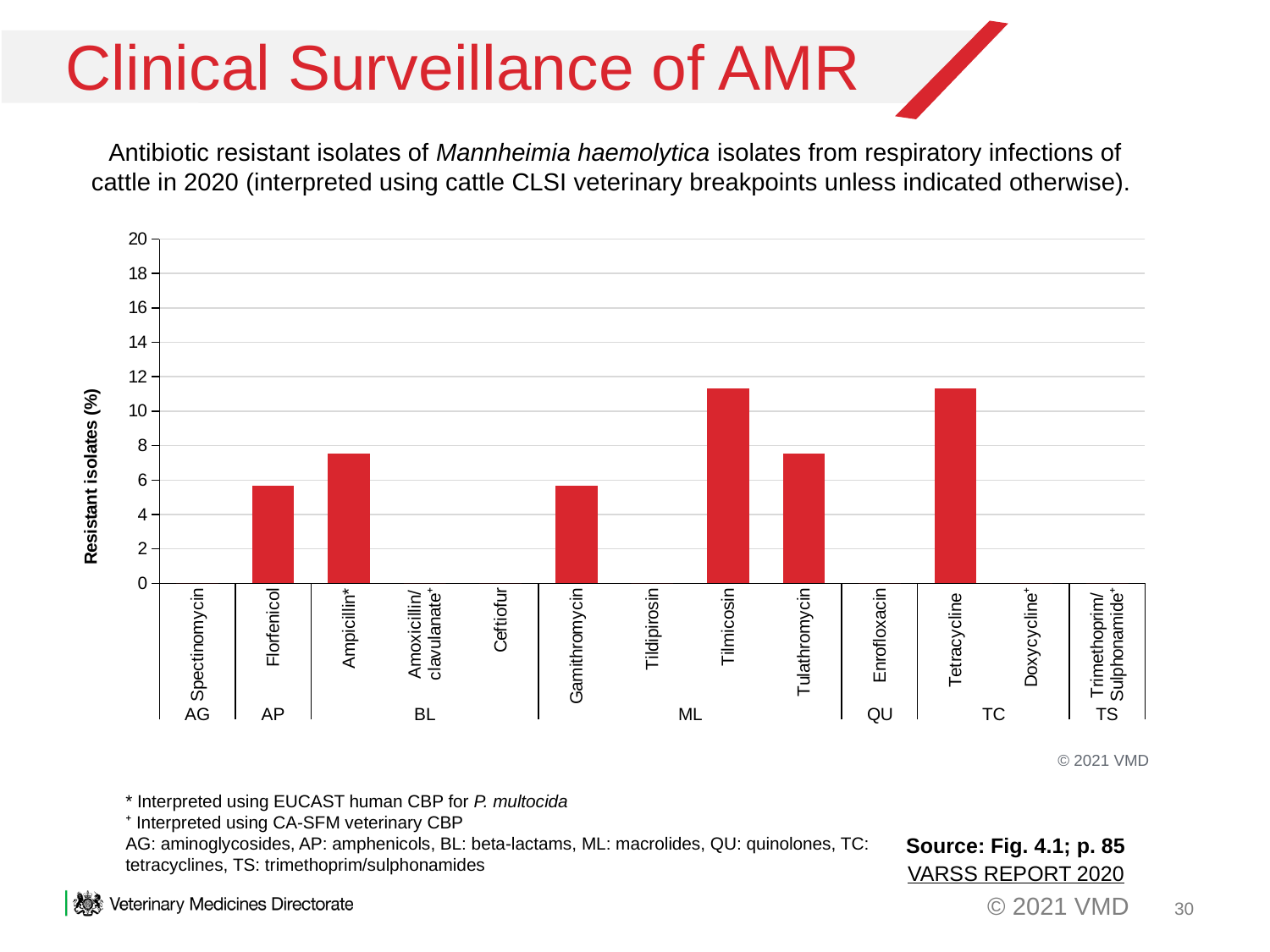
Is the value for Tilmicosin greater or less than 10? greater What is the value for Enrofloxacin? 0 What type of chart is shown on the slide? bar chart Is the value for Ampicillin* greater or less than 8? less How many antimicrobial class groups (AG, AP, BL, ML, QU, TC, TS) are shown along the x axis? 7 What is the label of the y axis of the chart? Resistant isolates (%) Is the value for Florfenicol greater or less than 4? greater Which has the larger value, Tilmicosin or Florfenicol? Tilmicosin Which has the larger value, Tulathromycin or Gamithromycin? Tulathromycin How many antibiotics are listed along the x axis of the chart? 13